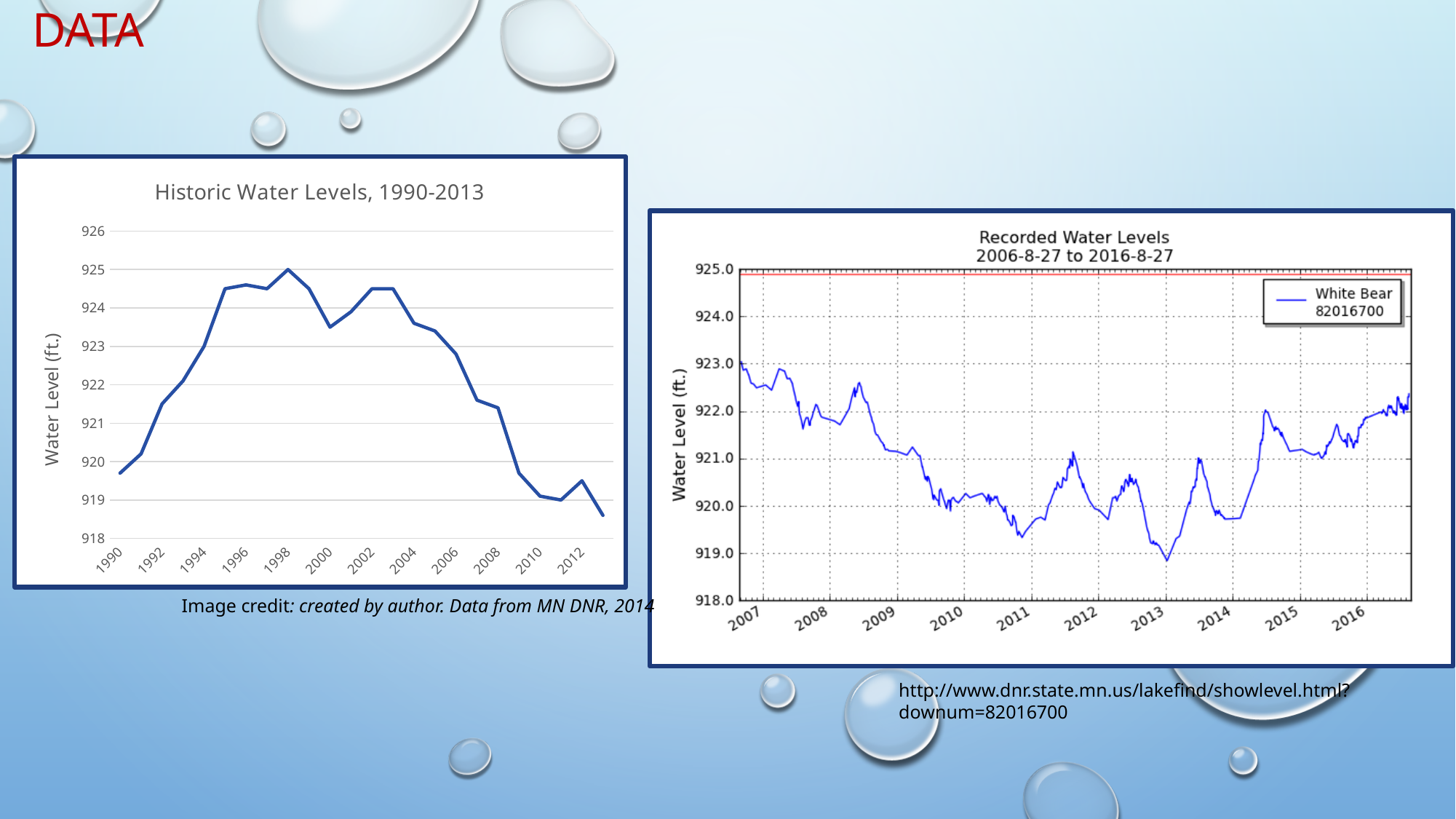
In the 'Historic Water Levels, 1990-2013' chart, do the values rise or fall from 2004 to 2013? fall How many series does the legend of the 'Recorded Water Levels 2006-8-27 to 2016-8-27' chart list? 1 In the 'Historic Water Levels, 1990-2013' chart, is the value for 1996 greater or less than 924? greater In the 'Historic Water Levels, 1990-2013' chart, is the value for 1990 greater or less than 920? less In the 'Historic Water Levels, 1990-2013' chart, which year has the highest water level? 1998 In the 'Historic Water Levels, 1990-2013' chart, is the value for 2010 greater or less than 920? less What kind of chart is the 'Historic Water Levels, 1990-2013' chart? line chart What kind of chart is the 'Recorded Water Levels 2006-8-27 to 2016-8-27' chart? line chart What is the legend entry in the 'Recorded Water Levels 2006-8-27 to 2016-8-27' chart? White Bear 82016700 In the 'Historic Water Levels, 1990-2013' chart, is the water level in 1996 higher or lower than in 2010? higher In the 'Historic Water Levels, 1990-2013' chart, which year has the lowest water level? 2013